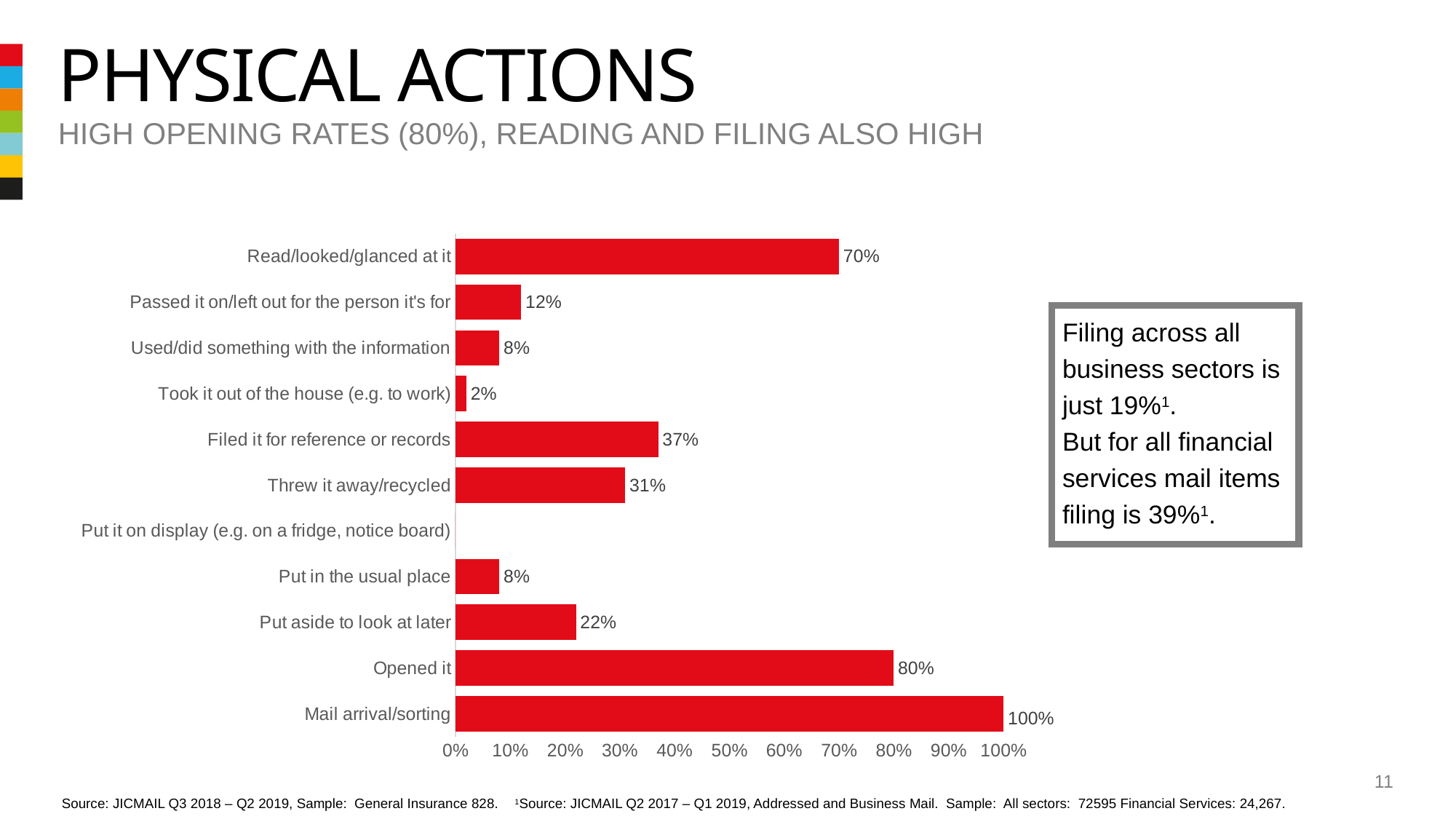
Which is larger: the value for "Passed it on/left out for the person it's for" or the value for "Used/did something with the information"? Passed it on/left out for the person it's for What is the value for "Took it out of the house (e.g. to work)"? 2% What kind of chart is shown on the slide? bar chart Is the value for "Threw it away/recycled" greater or less than 40%? less What is the value for "Filed it for reference or records"? 37% What is the difference between the values for "Opened it" and "Read/looked/glanced at it"? 10% What is the difference between the values for "Filed it for reference or records" and "Threw it away/recycled"? 6% What is the value for "Opened it"? 80% What colour are the bars in the chart? red How many categories are listed on the chart? 11 What is the value for "Put aside to look at later"? 22% Which category has the highest value? Mail arrival/sorting